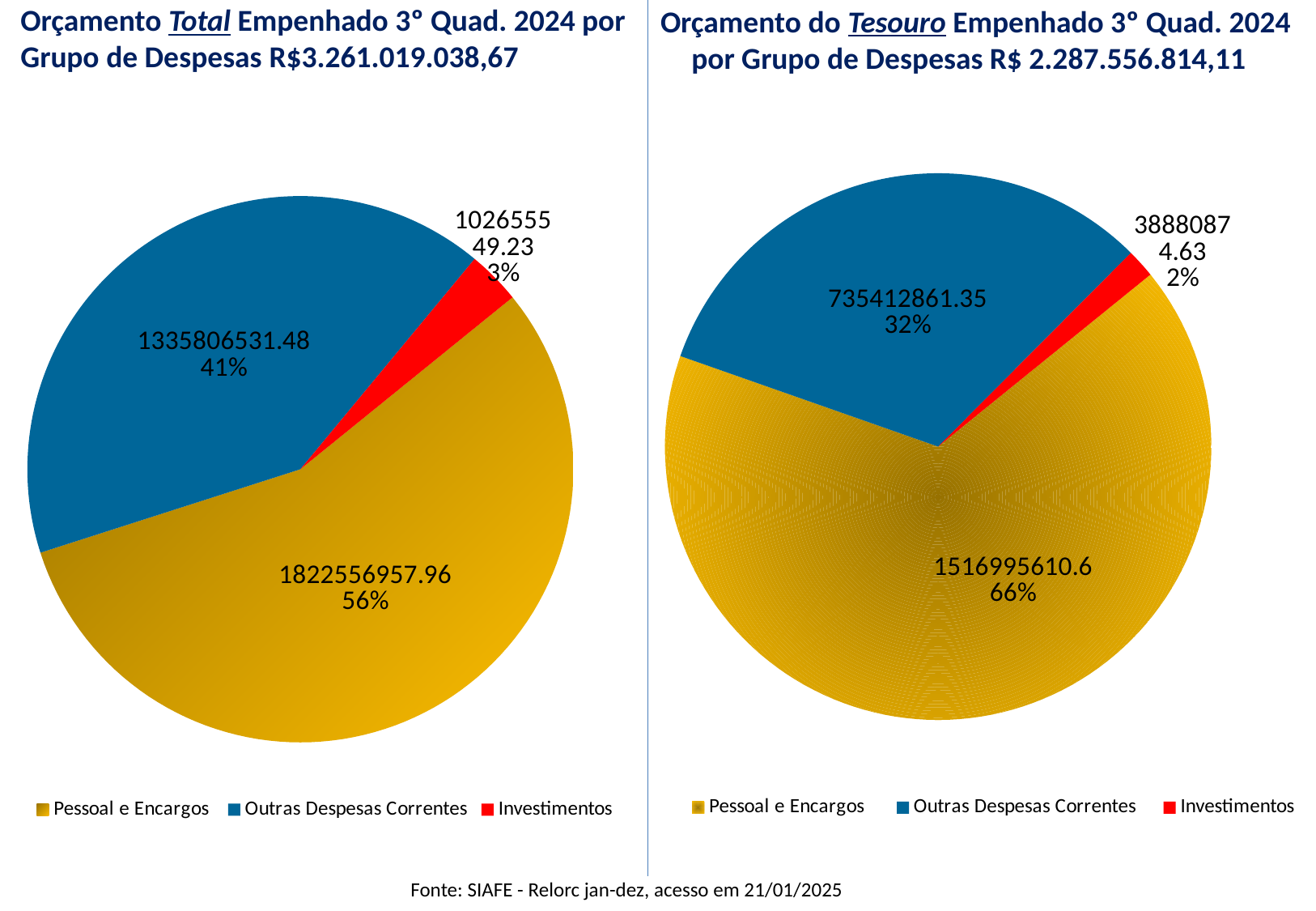
How many categories does the legend of the left chart (Orçamento Total) list? 3 In the right chart (Orçamento do Tesouro), what percentage share does Pessoal e Encargos have? 66% What kind of chart is the left chart, 'Orçamento Total Empenhado 3° Quad. 2024 por Grupo de Despesas'? Pie chart In the left chart (Orçamento Total), what percentage share does Outras Despesas Correntes have? 41% In the left chart (Orçamento Total), what percentage share does Investimentos have? 3% In the right chart (Orçamento do Tesouro), which is larger: Outras Despesas Correntes or Investimentos? Outras Despesas Correntes In the right chart (Orçamento do Tesouro), what value is shown for Outras Despesas Correntes? 735412861.35 What total amount is stated in the title of the right chart (Orçamento do Tesouro)? R$ 2.287.556.814,11 In the right chart (Orçamento do Tesouro), what value is shown for Pessoal e Encargos? 1516995610.6 In the left chart (Orçamento Total), which category has the largest slice? Pessoal e Encargos In the left chart (Orçamento Total), what value is shown for Pessoal e Encargos? 1822556957.96 In the right chart (Orçamento do Tesouro), which category has the smallest slice? Investimentos